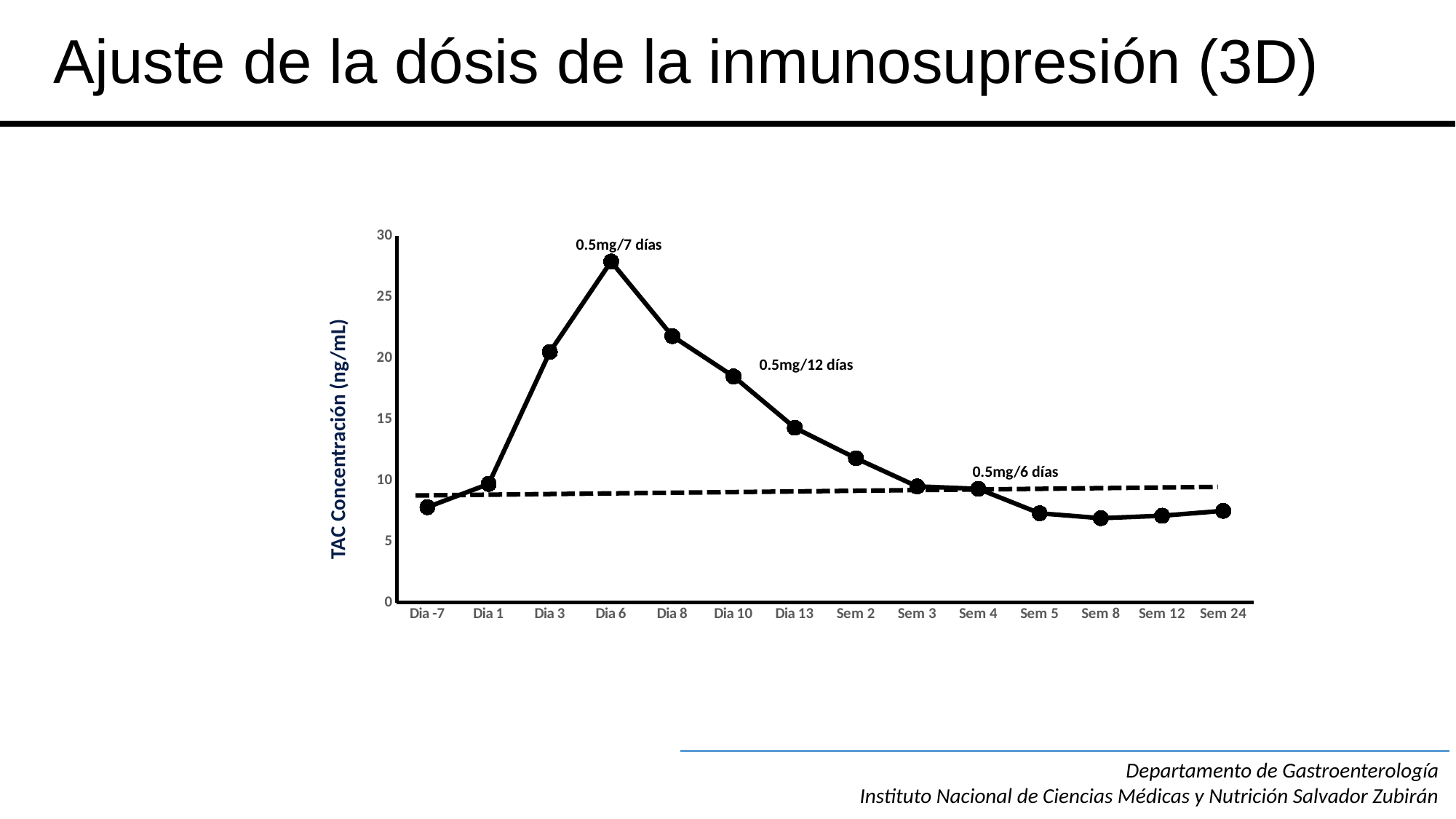
Which has a higher TAC concentration, Dia 1 or Dia 6? Dia 6 Is the TAC concentration at Dia 10 greater or less than 15? greater Which has a higher TAC concentration, Dia 10 or Sem 2? Dia 10 Is the TAC concentration at Dia 8 greater or less than 20? greater Is the TAC concentration at Dia 6 greater or less than 25? greater How many time points are plotted along the x axis? 14 What is the label of the y axis? TAC Concentración (ng/mL) What kind of chart is shown on the slide? line chart At which time point is the TAC concentration highest? Dia 6 Does the TAC concentration rise or fall from Dia 6 to Sem 8? fall